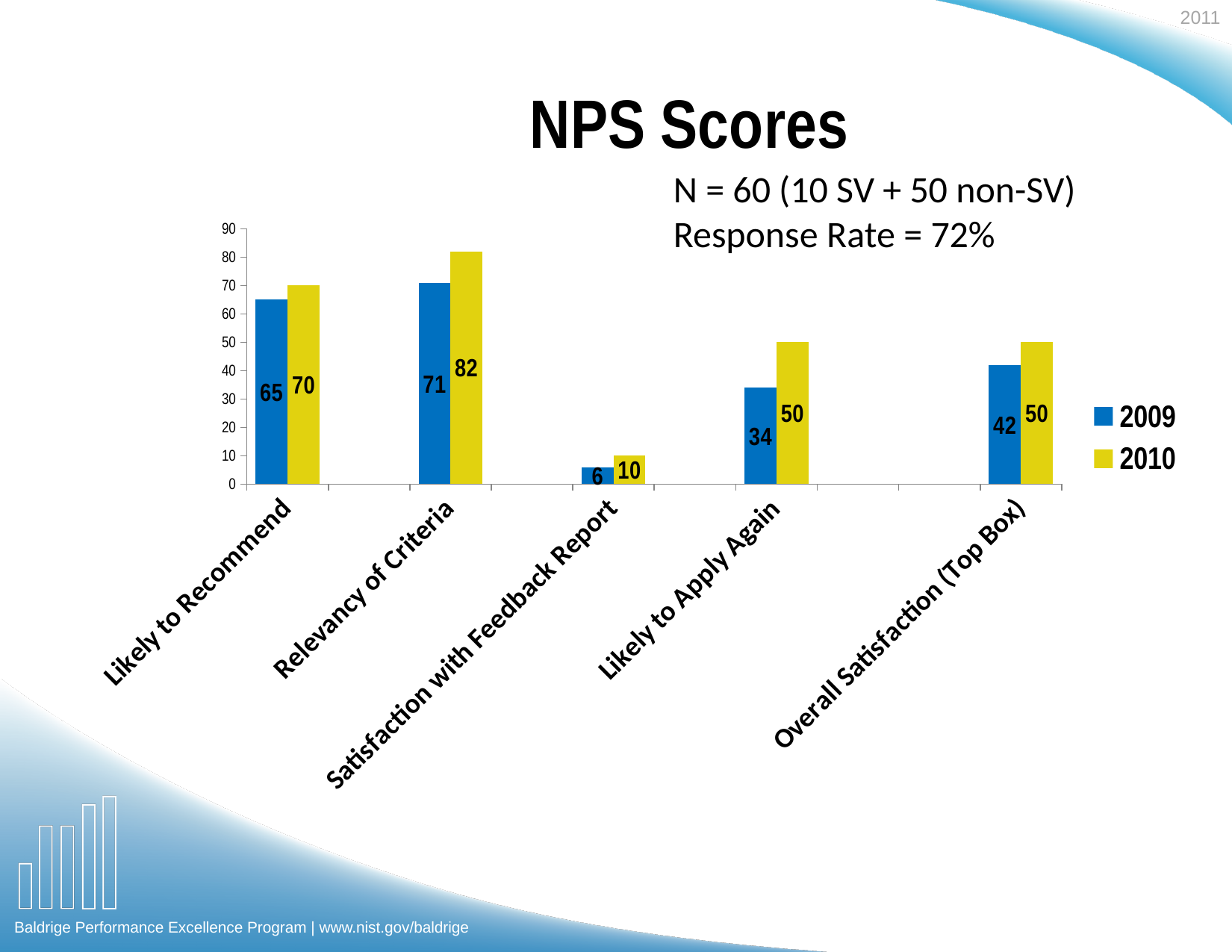
What is the difference between the 2010 and 2009 values for Likely to Apply Again? 16 How many categories are shown on the x axis? 5 What is the 2009 value for Likely to Apply Again? 34 How many series does the legend list? 2 Is the 2010 value for Overall Satisfaction (Top Box) greater or less than 40? greater Which category has the highest 2010 value? Relevancy of Criteria What is the 2009 value for Satisfaction with Feedback Report? 6 Which category has the lowest 2009 value? Satisfaction with Feedback Report What is the 2010 value for Relevancy of Criteria? 82 What kind of chart is shown on the slide? bar chart Which is larger: the 2009 value for Likely to Recommend or the 2009 value for Overall Satisfaction (Top Box)? Likely to Recommend What is the title of the chart? NPS Scores